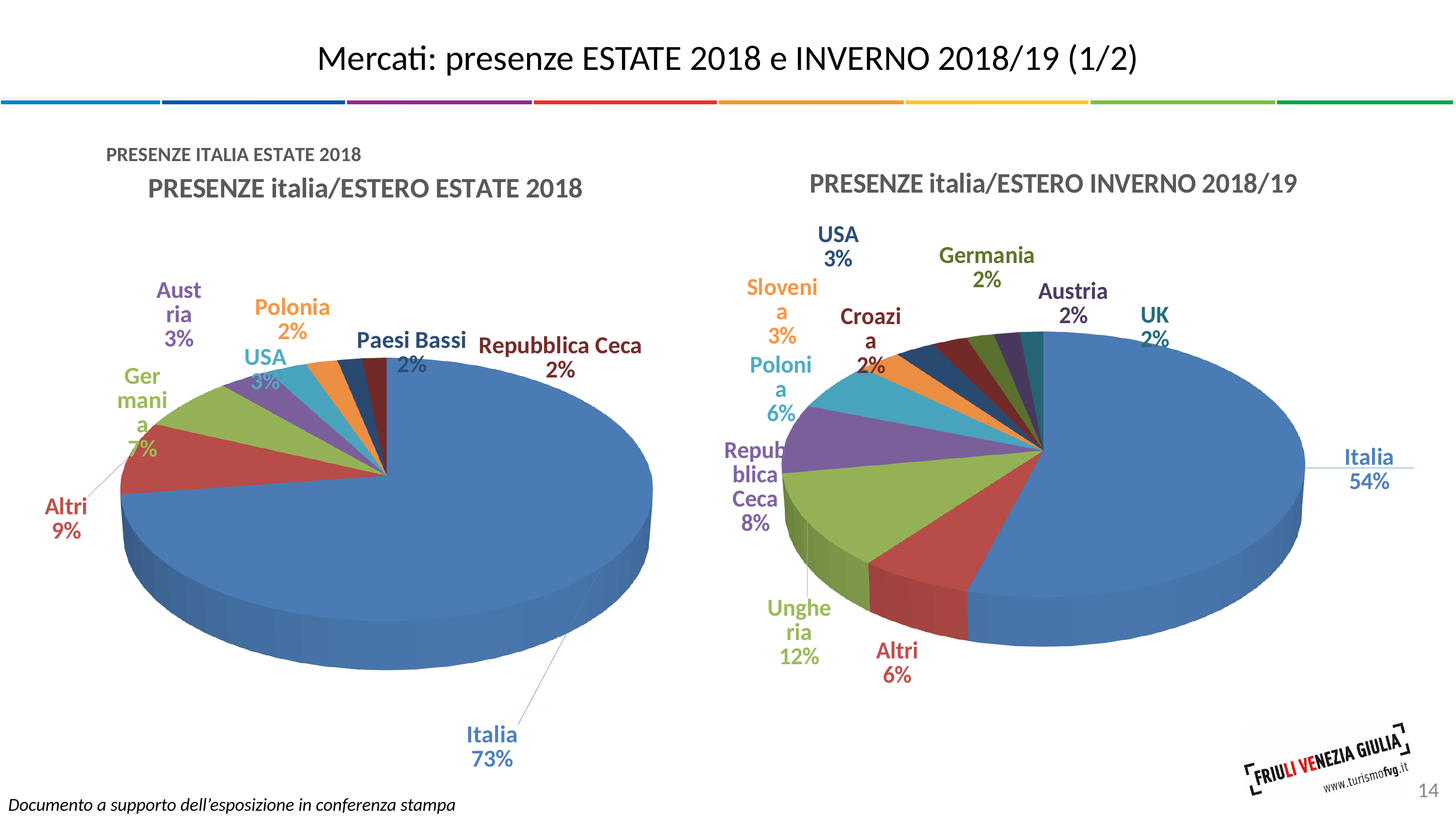
How many slices does the PRESENZE italia/ESTERO ESTATE 2018 pie chart have? 8 What type of chart is the PRESENZE italia/ESTERO ESTATE 2018 chart? Pie chart In the PRESENZE italia/ESTERO ESTATE 2018 chart, what is the difference between the shares of Italia and Altri? 64% How many slices does the PRESENZE italia/ESTERO INVERNO 2018/19 pie chart have? 11 In the PRESENZE italia/ESTERO INVERNO 2018/19 chart, which is larger, Polonia or Slovenia? Polonia In the PRESENZE italia/ESTERO INVERNO 2018/19 chart, what share does Italia have? 54% In the PRESENZE italia/ESTERO INVERNO 2018/19 chart, what is the value for Ungheria? 12% In the PRESENZE italia/ESTERO ESTATE 2018 chart, what share does Italia have? 73% In the PRESENZE italia/ESTERO INVERNO 2018/19 chart, what is the value for Repubblica Ceca? 8% In the PRESENZE italia/ESTERO ESTATE 2018 chart, what is the value for Altri? 9% In the PRESENZE italia/ESTERO INVERNO 2018/19 chart, which category other than Italia has the largest share? Ungheria In the PRESENZE italia/ESTERO ESTATE 2018 chart, what is the value for Germania? 7%